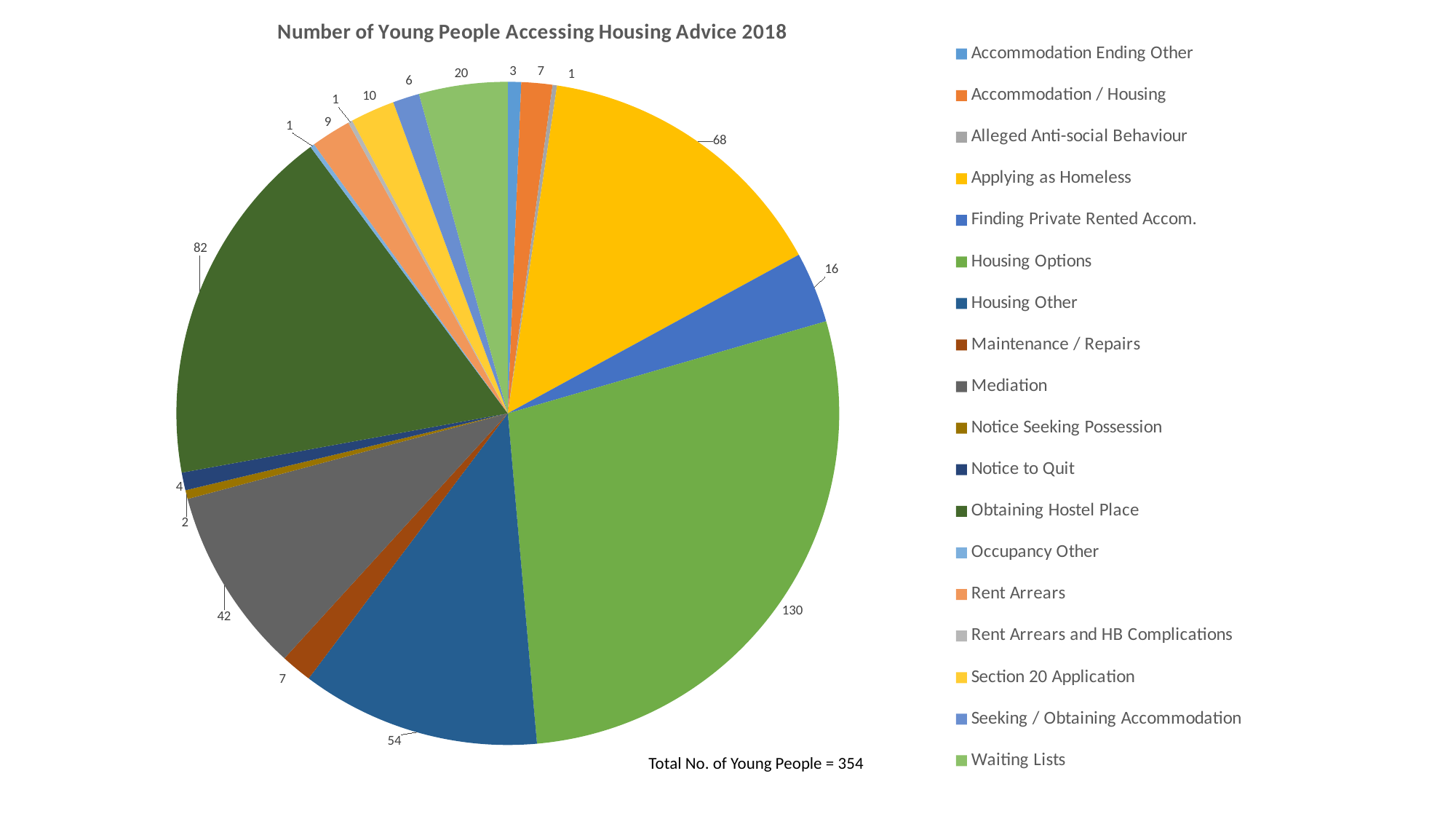
What is the value for Applying as Homeless? 68 Which is larger, Housing Other or Mediation? Housing Other How many categories does the legend list? 18 Which category has the largest slice? Housing Options What is the title of the chart? Number of Young People Accessing Housing Advice 2018 What is the difference between the values for Housing Options and Obtaining Hostel Place? 48 What is the difference between the values for Applying as Homeless and Finding Private Rented Accom.? 52 What is the value for Housing Options? 130 What kind of chart is shown on the slide? pie chart What is the value for Mediation? 42 What is the value for Obtaining Hostel Place? 82 What is the value for Waiting Lists? 20